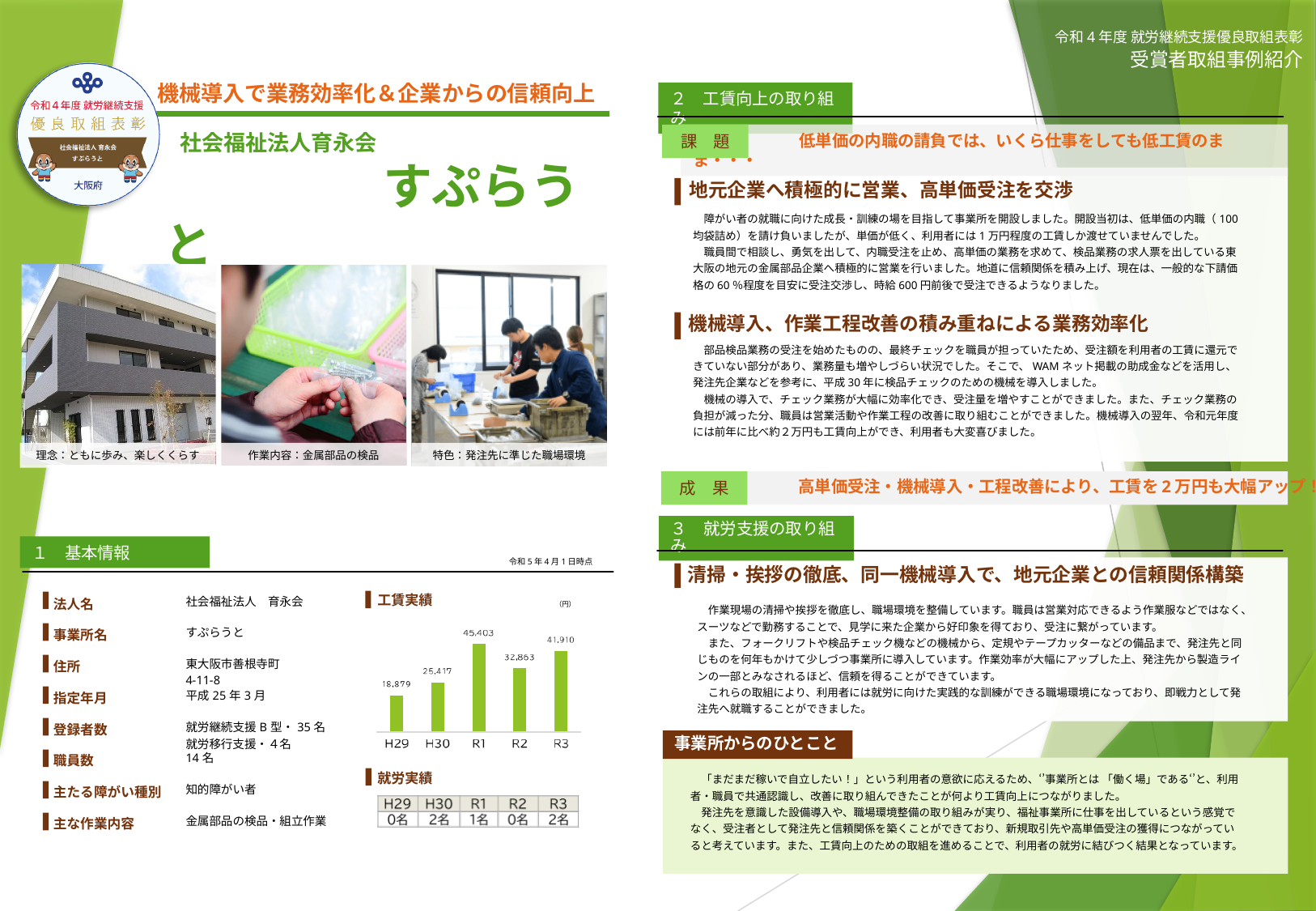
In the 工賃実績 chart, which is larger, the value for R2 or the value for R3? R3 In the 工賃実績 chart, what is the value for R1? 45,403 In the 工賃実績 chart, does the value rise or fall from H29 to R1? rise In the 工賃実績 chart, what is the value for H29? 18,879 How many bars are shown in the 工賃実績 chart? 5 In the 工賃実績 chart, which year has the highest value? R1 In the 工賃実績 chart, what is the value for R3? 41,910 In the 工賃実績 chart, what is the difference between the values for R1 and R2? 12,540 What kind of chart is the 工賃実績 chart? bar chart In the 工賃実績 chart, what is the difference between the values for H30 and H29? 6,538 What unit is indicated in the top right of the 工賃実績 chart? 円 In the 工賃実績 chart, which year has the lowest value? H29